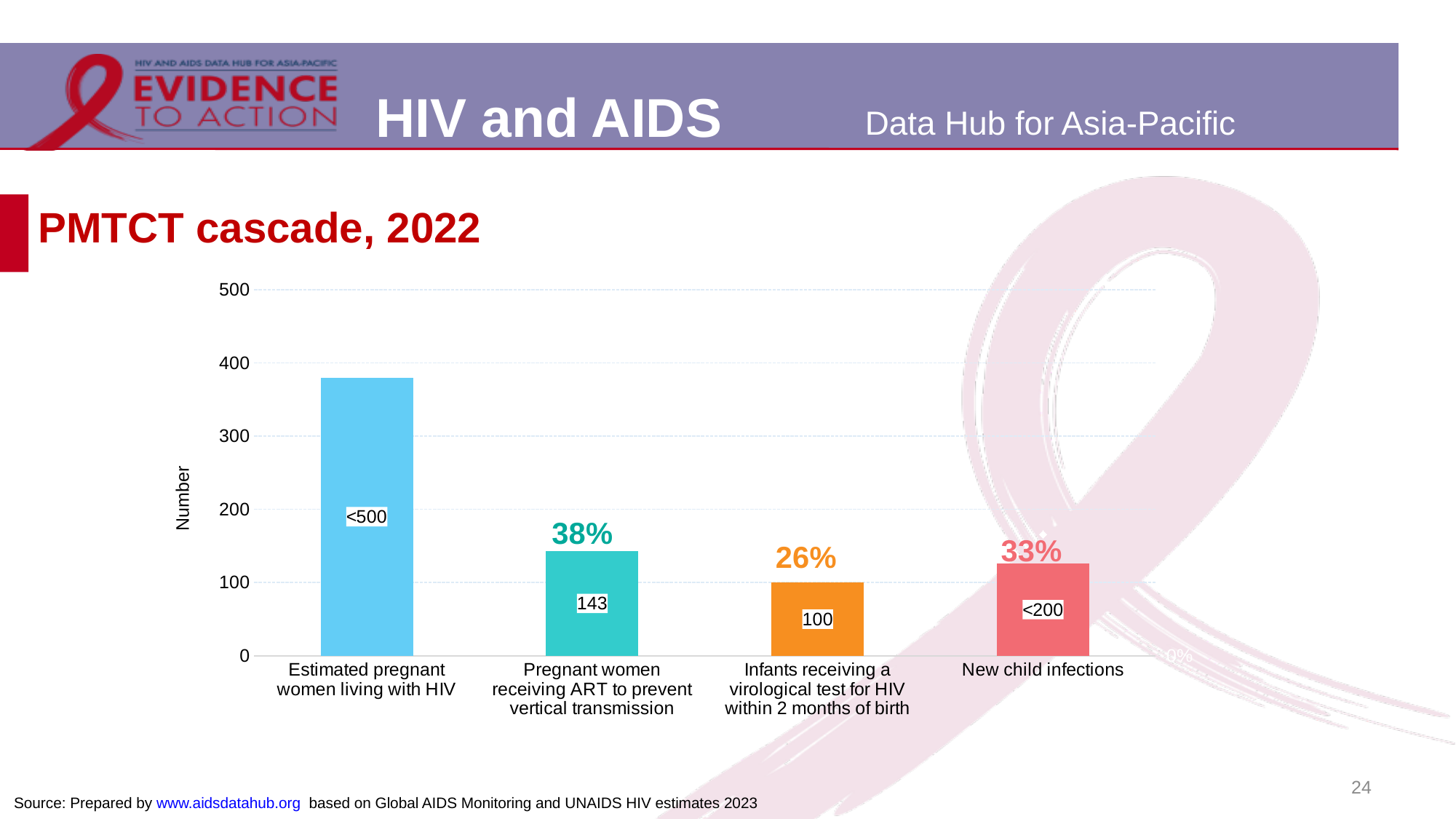
What is the difference between the value for Pregnant women receiving ART to prevent vertical transmission and the value for Infants receiving a virological test for HIV within 2 months of birth? 43 Which category has the shortest bar? Infants receiving a virological test for HIV within 2 months of birth What is the data label on the bar for Pregnant women receiving ART to prevent vertical transmission? 143 What percentage is shown above the bar for New child infections? 33% Which category has the tallest bar? Estimated pregnant women living with HIV What is the title of the y axis? Number What percentage is shown above the bar for Pregnant women receiving ART to prevent vertical transmission? 38% How many categories are shown on the x axis? 4 What is the data label on the bar for Infants receiving a virological test for HIV within 2 months of birth? 100 What is the data label on the bar for New child infections? <200 What is the data label on the bar for Estimated pregnant women living with HIV? <500 Is the bar for Estimated pregnant women living with HIV greater or less than 300? greater